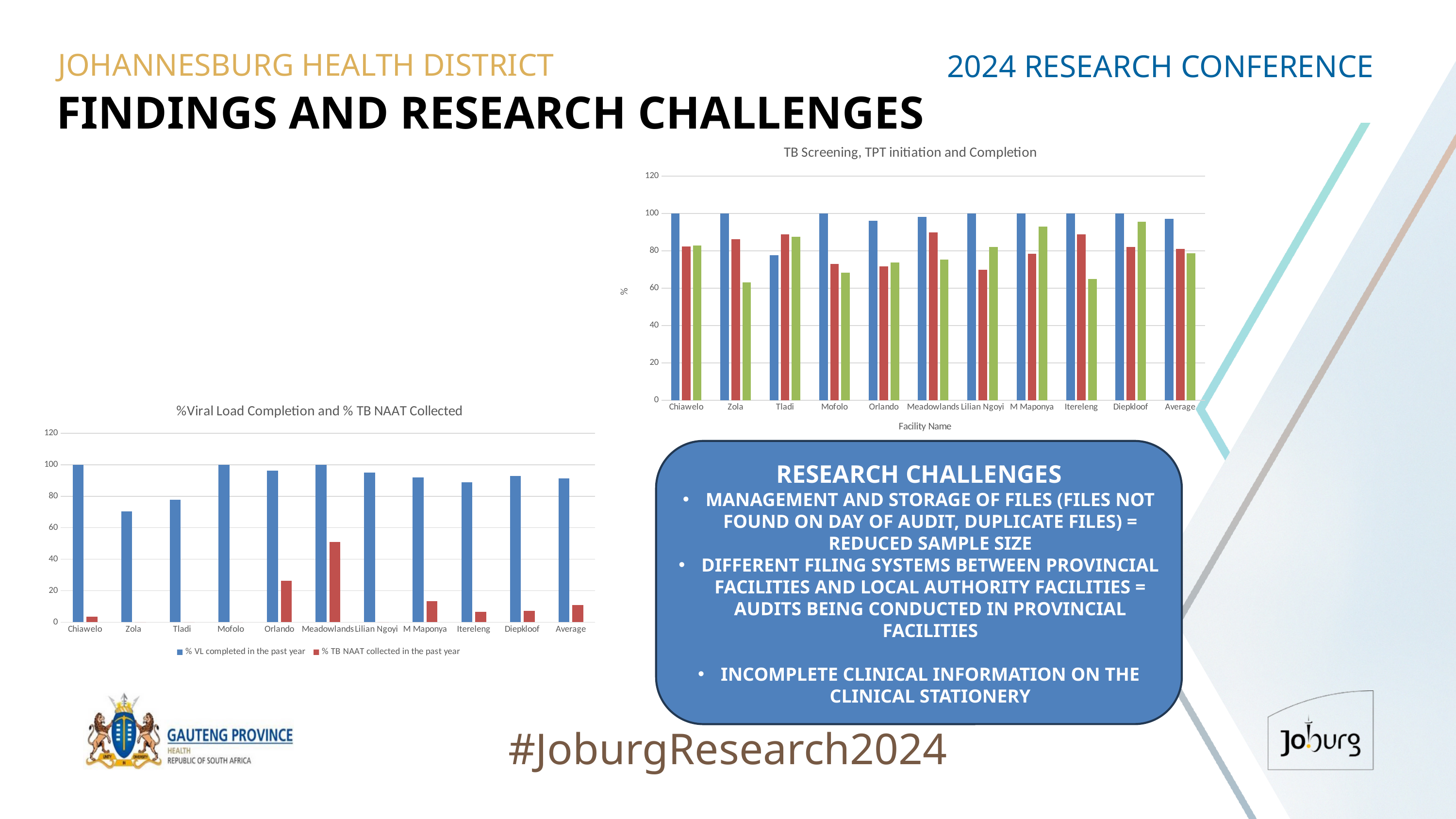
What is the label on the x axis of the 'TB Screening, TPT initiation and Completion' chart? Facility Name In the 'TB Screening, TPT initiation and Completion' chart, is the green (third) bar for Itereleng greater or less than 80? less In the '%Viral Load Completion and % TB NAAT Collected' chart, is the % VL completed for Zola greater or less than 80? less In the '%Viral Load Completion and % TB NAAT Collected' chart, which facility has the highest % TB NAAT collected in the past year? Meadowlands How many series does the legend of the '%Viral Load Completion and % TB NAAT Collected' chart list? 2 How many facilities (categories) are shown on the x axis of the 'TB Screening, TPT initiation and Completion' chart? 11 In the 'TB Screening, TPT initiation and Completion' chart, which facility has the lowest value for the blue (first) series? Tladi In the '%Viral Load Completion and % TB NAAT Collected' chart, which facility has the lowest % TB NAAT collected in the past year? Zola, Tladi, Mofolo and Lilian Ngoyi (all 0, no bar shown) In the '%Viral Load Completion and % TB NAAT Collected' chart, is the % TB NAAT collected for Meadowlands greater or less than 40? greater What kind of chart is the '%Viral Load Completion and % TB NAAT Collected' chart? bar chart In the '%Viral Load Completion and % TB NAAT Collected' chart, what is the % VL completed in the past year for Mofolo? 100 In the '%Viral Load Completion and % TB NAAT Collected' chart, which facility has the lowest % VL completed in the past year? Zola